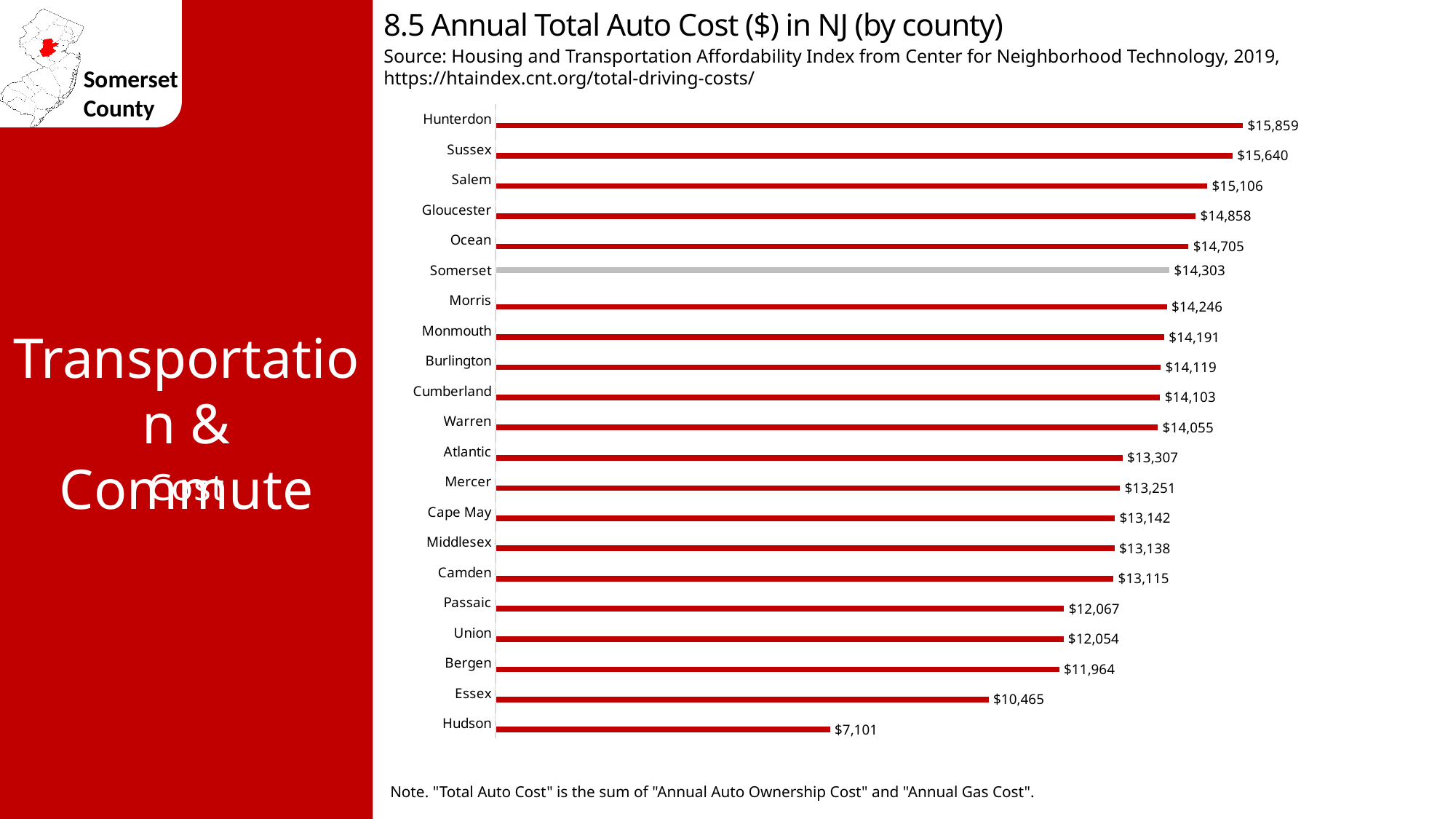
Which county has the highest annual total auto cost? Hunterdon Which county's bar is shown in gray instead of red? Somerset What is the annual total auto cost for Somerset county? $14,303 Which county has the lowest annual total auto cost? Hudson What is the difference in annual total auto cost between Somerset and Morris? $57 What kind of chart is shown on the slide? Bar chart How many counties are shown in the chart? 21 What is the annual total auto cost for Morris county? $14,246 What is the annual total auto cost for Hudson county? $7,101 Which has a higher annual total auto cost, Sussex or Salem? Sussex Which has a higher annual total auto cost, Essex or Bergen? Bergen What is the difference in annual total auto cost between Hunterdon and Hudson? $8,758